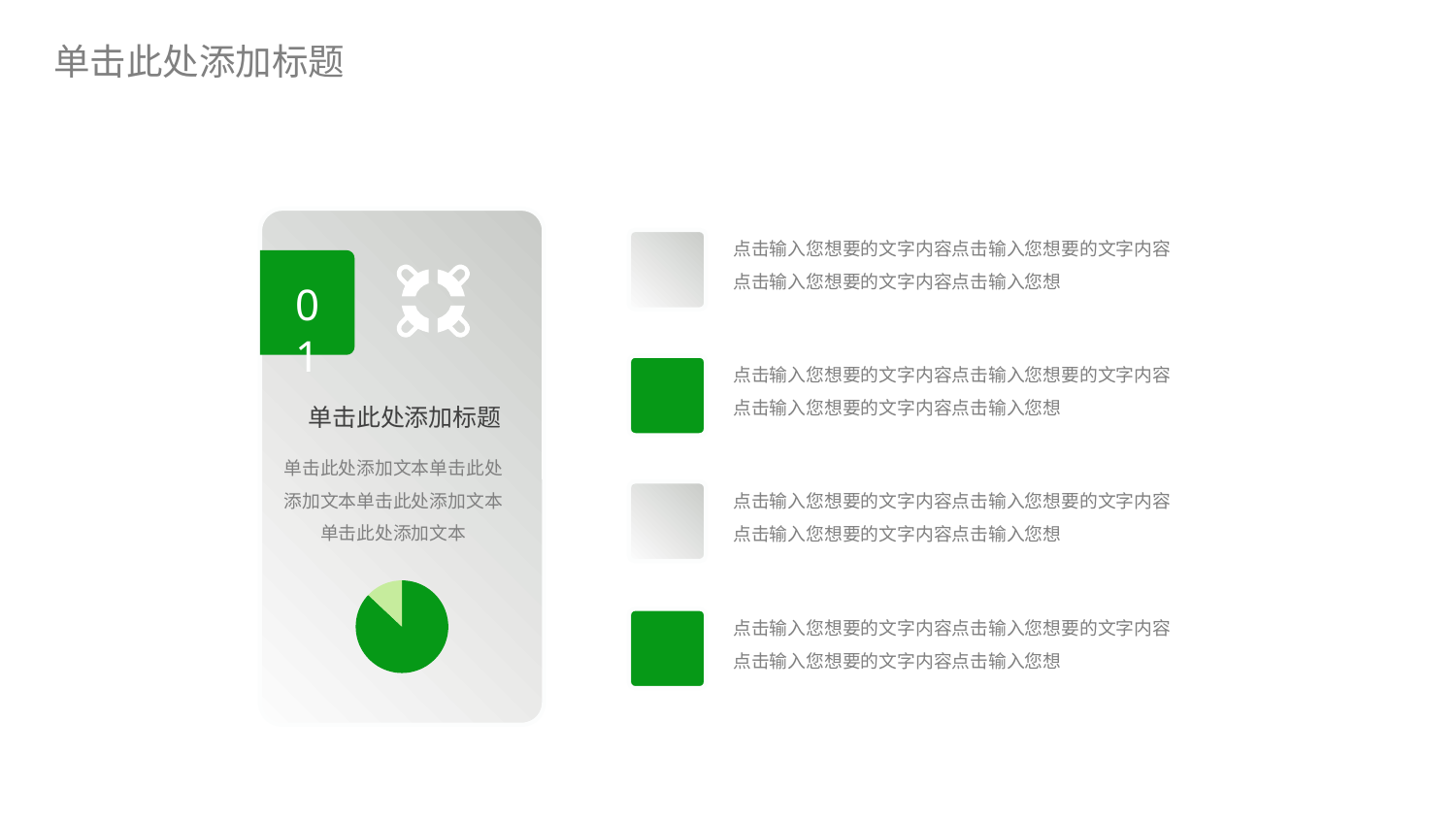
How many slices does the pie chart on the slide have? 2 In the pie chart, which slice is larger: the dark green slice or the light green slice? the dark green slice What kind of chart is shown inside the card on the left of the slide? pie chart What two colours are used for the slices of the pie chart? dark green and light green Does the pie chart on the slide display any data labels with values? No In the pie chart, which slice is the smallest? the light green slice In the pie chart, which slice is the largest? the dark green slice